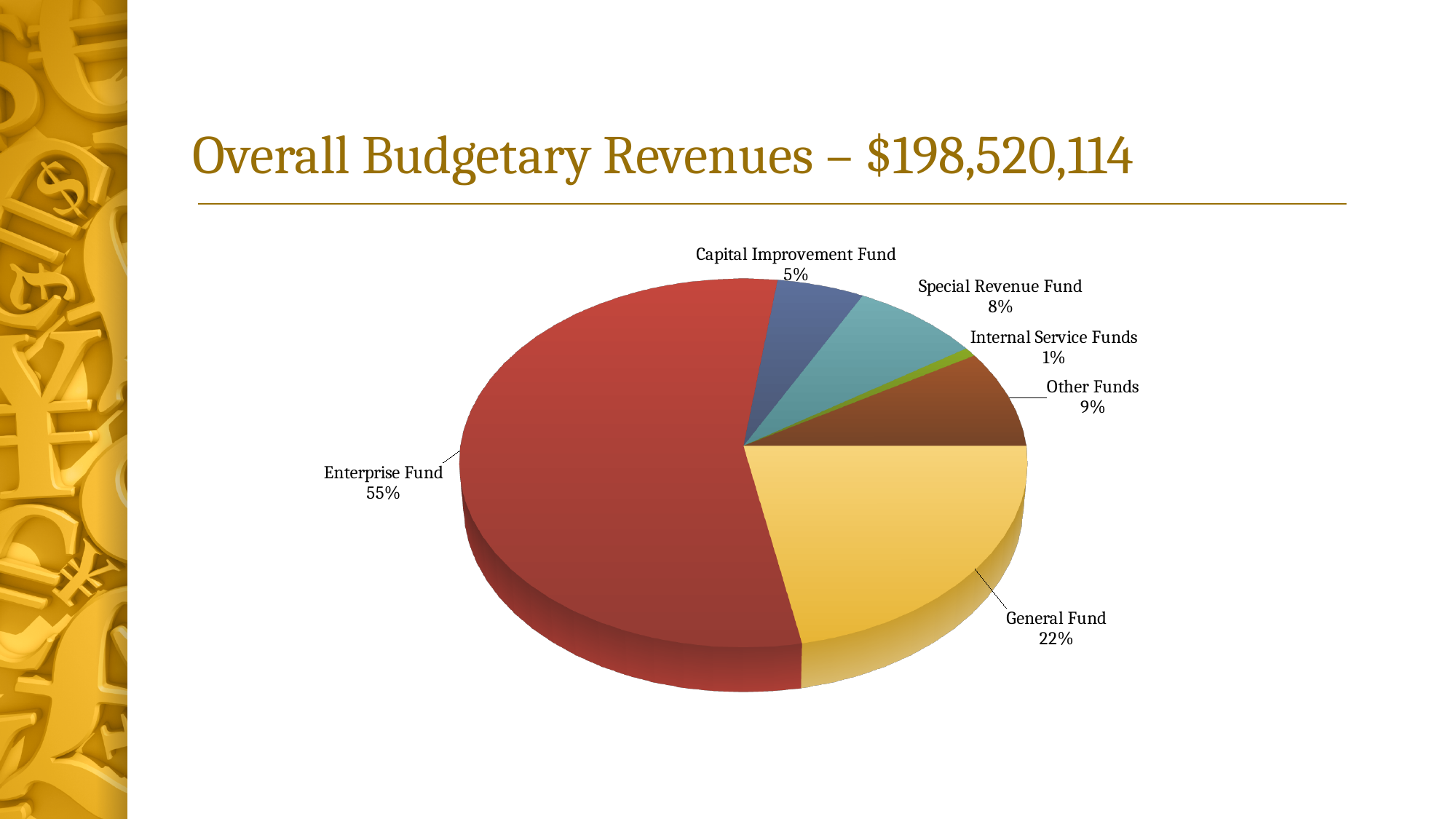
What percentage is shown for Other Funds? 9% What percentage is shown for the Capital Improvement Fund? 5% Which is larger, the share for Other Funds or the share for the Special Revenue Fund? Other Funds What is the difference in percentage points between the Enterprise Fund and the General Fund? 33 How many slices does the pie chart have? 6 What percentage is shown for the Special Revenue Fund? 8% What total amount is given in the slide title for overall budgetary revenues? $198,520,114 Which fund has the largest share of the pie? Enterprise Fund Which fund has the smallest share of the pie? Internal Service Funds What share of the pie does the Enterprise Fund represent? 55% What share of the pie does the General Fund represent? 22% What kind of chart is shown on the slide? Pie chart